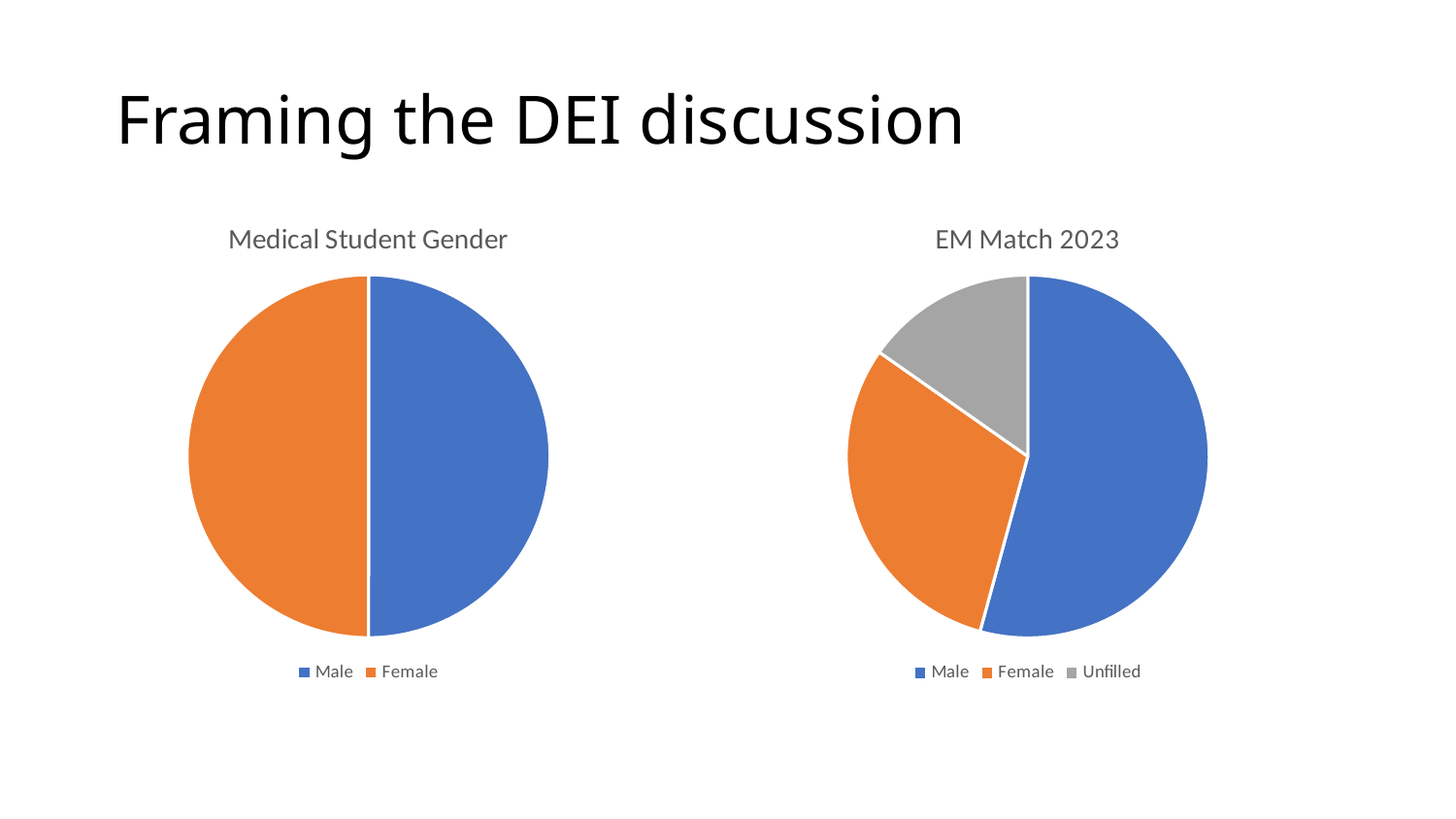
What is the title of the chart on the right side of the slide? EM Match 2023 In the "EM Match 2023" chart, which category has the largest slice? Male What type of chart is the "Medical Student Gender" chart? pie chart How many entries does the legend of the "Medical Student Gender" chart list? 2 How many slices does the "Medical Student Gender" chart have? 2 In the "EM Match 2023" chart, which slice is larger, Male or Female? Male In the "EM Match 2023" chart, which slice is larger, Female or Unfilled? Female In the "EM Match 2023" chart, what colour is the Unfilled slice? grey In the "EM Match 2023" chart, which category has the smallest slice? Unfilled What type of chart is the "EM Match 2023" chart? pie chart How many entries does the legend of the "EM Match 2023" chart list? 3 How many slices does the "EM Match 2023" chart have? 3